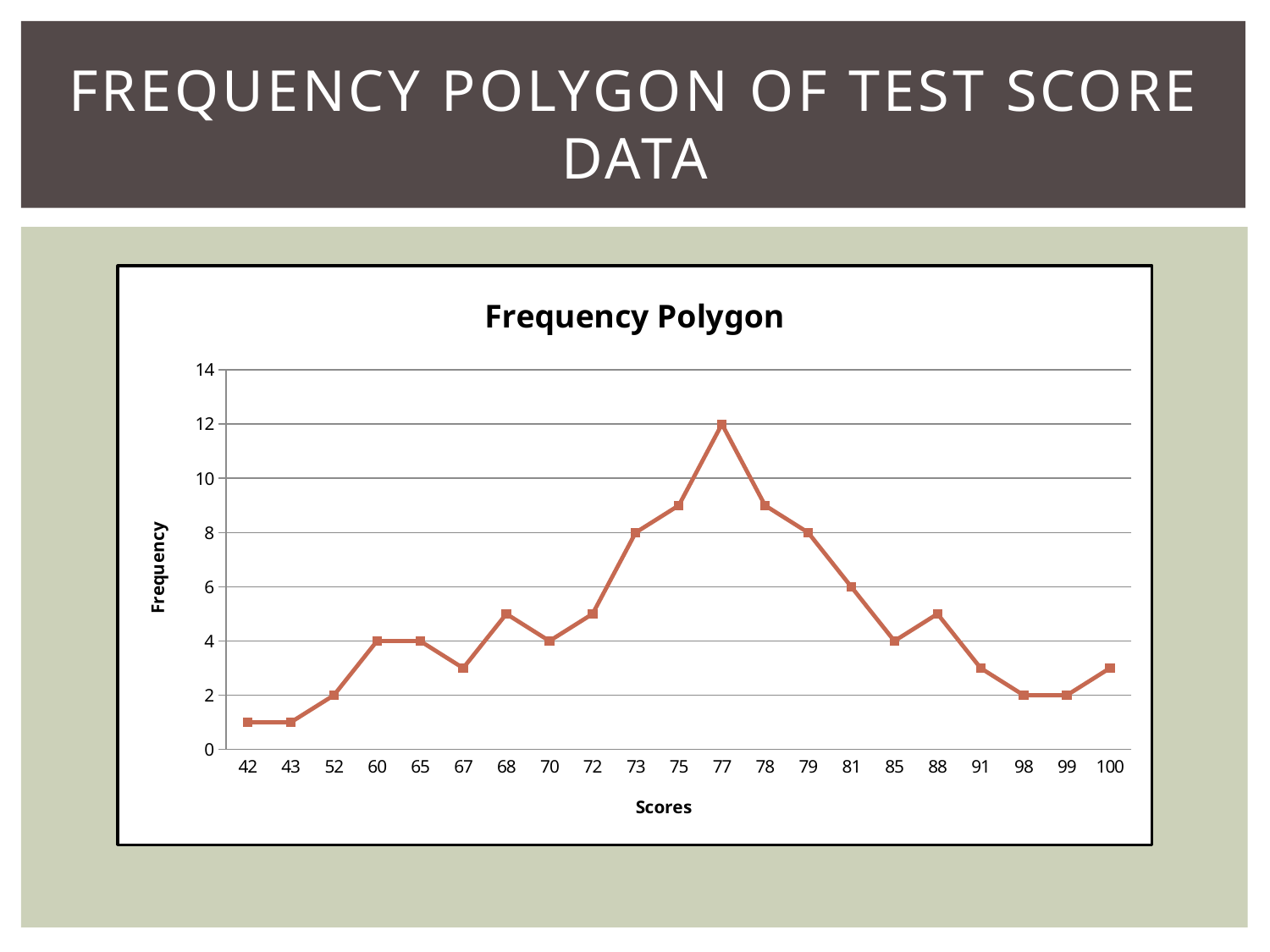
Does the frequency rise or fall from score 77 to score 98? fall Which score has the highest frequency? 77 Which has a higher frequency, score 73 or score 81? 73 What is the frequency for the score 77? 12 What is the difference between the frequency at score 77 and the frequency at score 73? 4 What is the label of the vertical axis? Frequency What is the frequency for the score 81? 6 Is the frequency for score 75 greater or less than 8? greater What kind of chart is shown on the slide? line chart How many score categories are plotted along the x axis? 21 What is the title of the chart? Frequency Polygon What is the frequency for the score 73? 8